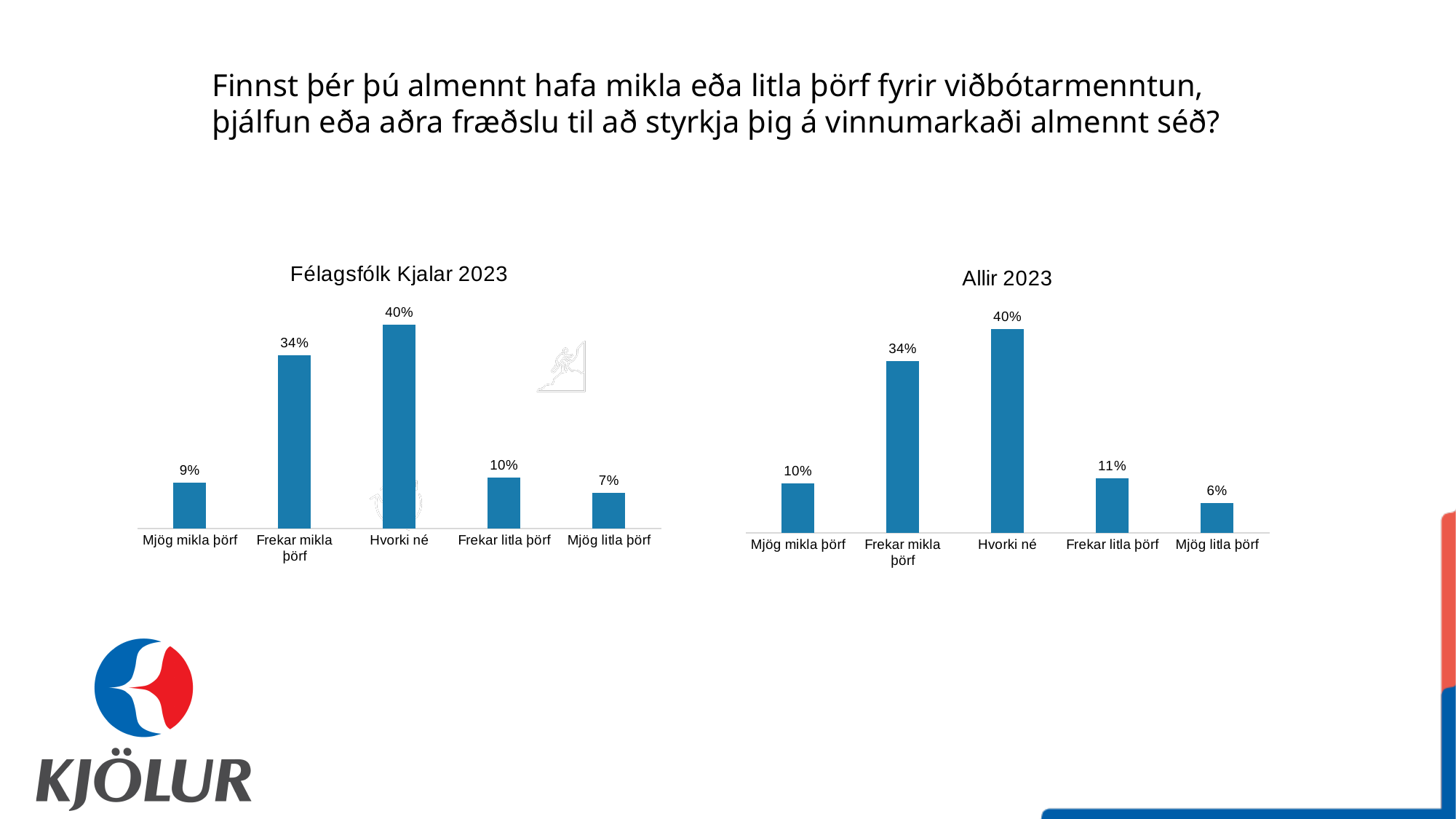
In the 'Félagsfólk Kjalar 2023' chart, what is the value for 'Hvorki né'? 40% How many categories does the 'Allir 2023' chart show? 5 In the 'Allir 2023' chart, what is the difference between 'Frekar mikla þörf' and 'Mjög mikla þörf'? 24% In the 'Allir 2023' chart, which category has the lowest value? Mjög litla þörf In the 'Allir 2023' chart, what is the value for 'Mjög litla þörf'? 6% In the 'Félagsfólk Kjalar 2023' chart, which is larger: 'Frekar litla þörf' or 'Mjög litla þörf'? Frekar litla þörf What kind of chart is the 'Félagsfólk Kjalar 2023' chart? Bar chart In the 'Allir 2023' chart, what is the value for 'Frekar litla þörf'? 11% In the 'Félagsfólk Kjalar 2023' chart, what is the value for 'Mjög mikla þörf'? 9% In the 'Félagsfólk Kjalar 2023' chart, what is the difference between 'Hvorki né' and 'Frekar mikla þörf'? 6% What is the title of the chart on the right side of the slide? Allir 2023 In the 'Félagsfólk Kjalar 2023' chart, which category has the highest value? Hvorki né